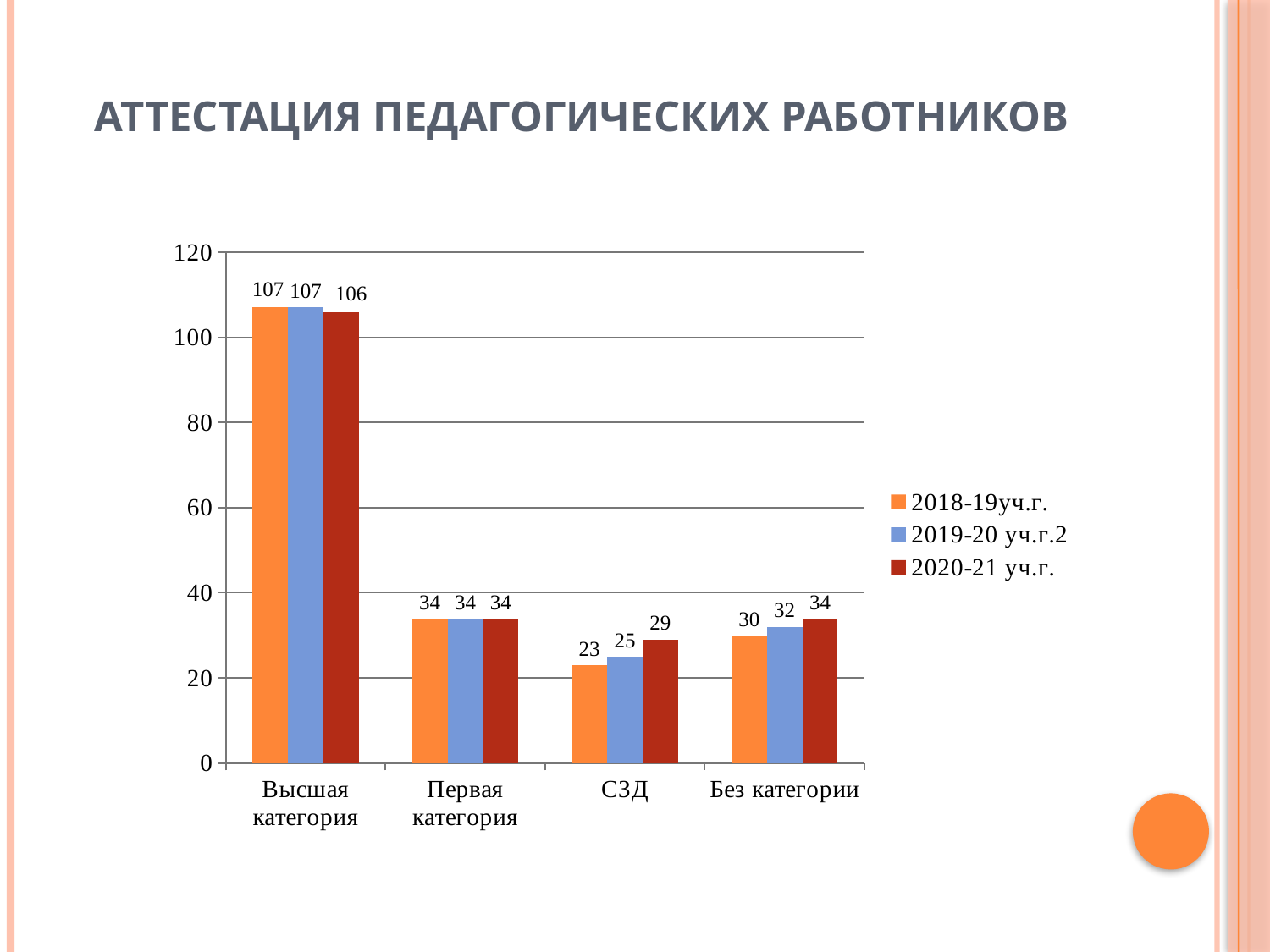
What is the value for Высшая категория in the 2020-21 уч.г. series? 106 Which category has the highest value in the 2018-19уч.г. series? Высшая категория How many series does the legend list? 3 Is the value for Первая категория in the 2019-20 уч.г.2 series greater or less than 40? less Which is larger for Без категории: the 2018-19уч.г. value or the 2020-21 уч.г. value? 2020-21 уч.г. What is the difference between the 2018-19уч.г. values for Высшая категория and Первая категория? 73 Which category has the lowest value in the 2020-21 уч.г. series? СЗД How many categories are shown on the x axis? 4 What is the value for СЗД in the 2018-19уч.г. series? 23 What is the value for Без категории in the 2019-20 уч.г.2 series? 32 What is the difference between the 2020-21 уч.г. and 2018-19уч.г. values for СЗД? 6 What kind of chart is shown on the slide? bar chart